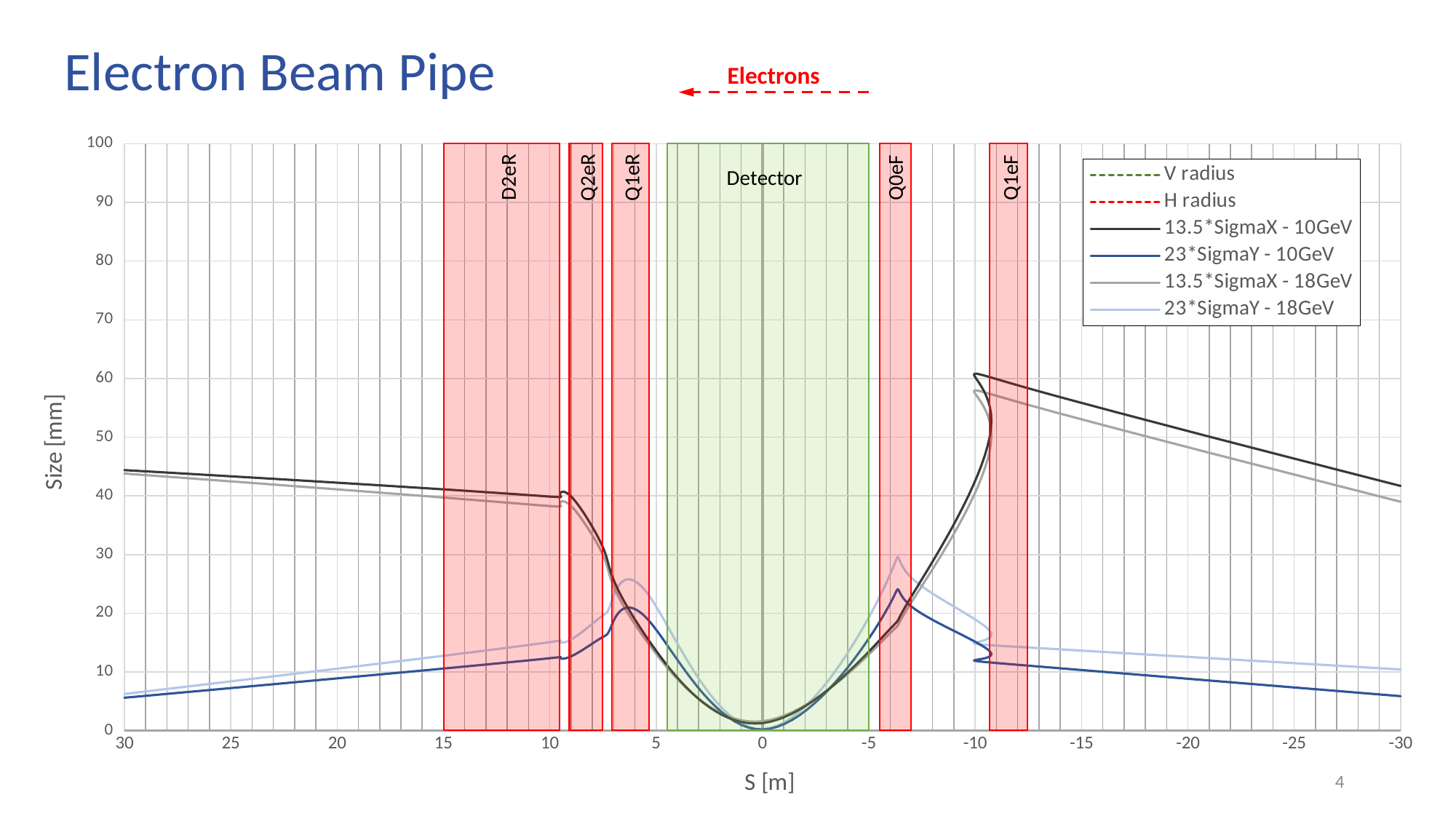
At S = 30 m, which is larger: 13.5*SigmaX - 10GeV or 23*SigmaY - 10GeV? 13.5*SigmaX - 10GeV What is the title of the slide containing the chart? Electron Beam Pipe What kind of chart is shown on the slide? line chart Is the value of 23*SigmaY - 10GeV at S = 30 m greater or less than 10? less What is the label of the vertical axis? Size [mm] Does the 13.5*SigmaX - 10GeV curve rise or fall as S goes from 30 m toward 0 m? fall Is the value of 13.5*SigmaX - 18GeV at S = -30 m greater or less than 50? less How many series does the legend list? 6 Is the value of 23*SigmaY - 18GeV at S = 0 m greater or less than 10? less